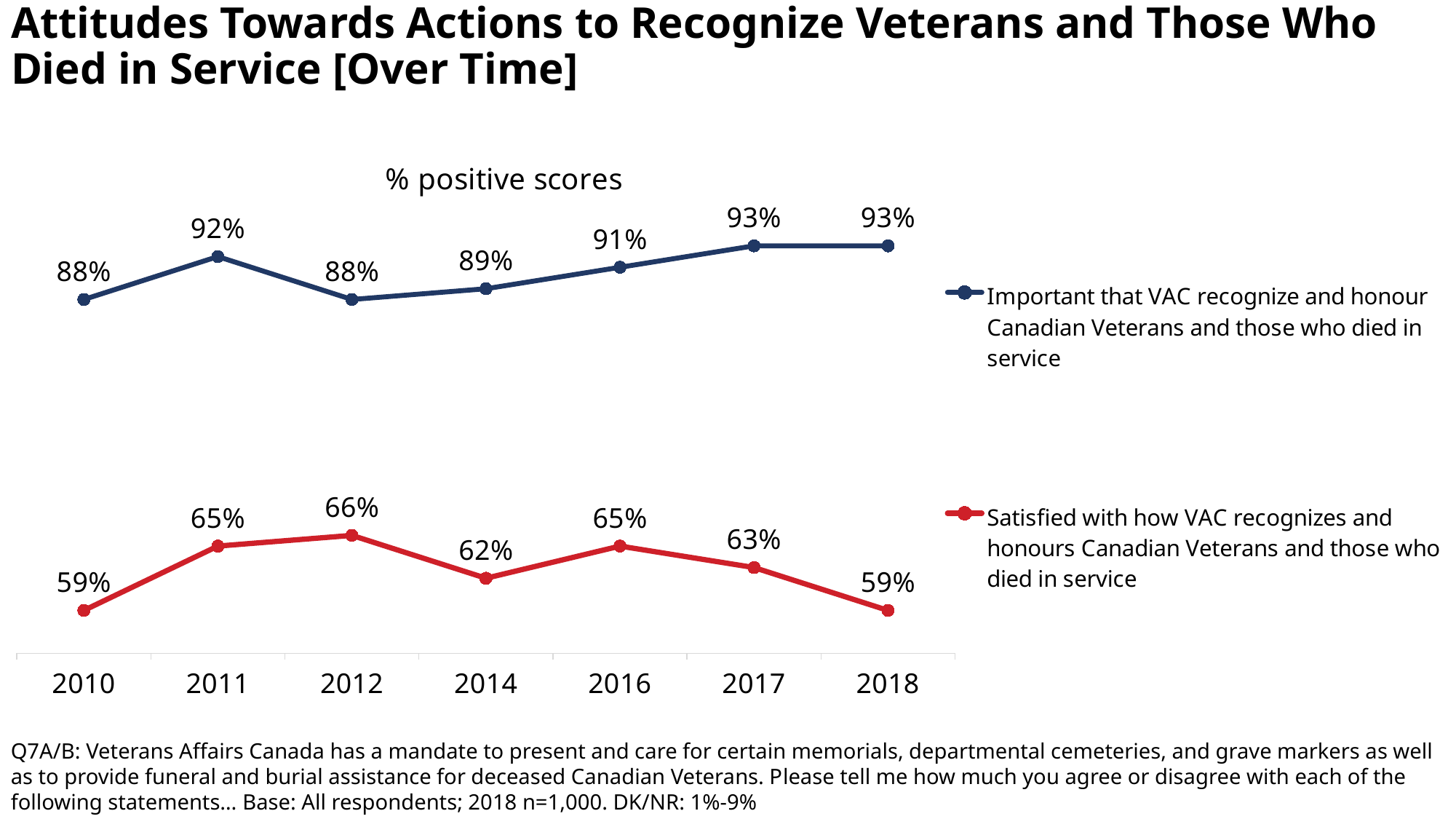
What is the difference between the two series in 2018? 34 percentage points What colour is the line for 'Satisfied with how VAC recognizes and honours Canadian Veterans and those who died in service'? Red What is the difference between the 2012 and 2018 values of the 'Satisfied with how VAC recognizes and honours' series? 7 percentage points What kind of chart is shown on the slide? Line chart Which is larger for the 'Satisfied with how VAC recognizes and honours' series: the 2011 value or the 2017 value? 2011 What is the lowest value of the 'Important that VAC recognize and honour' series? 88% What is the value for 'Important that VAC recognize and honour Canadian Veterans and those who died in service' in 2016? 91% How many years are shown on the x axis? 7 In which year is the 'Satisfied with how VAC recognizes and honours' series highest? 2012 Does the 'Important that VAC recognize and honour' series generally rise or fall from 2012 to 2017? Rise How many series does the legend list? 2 What is the value for 'Satisfied with how VAC recognizes and honours Canadian Veterans and those who died in service' in 2014? 62%